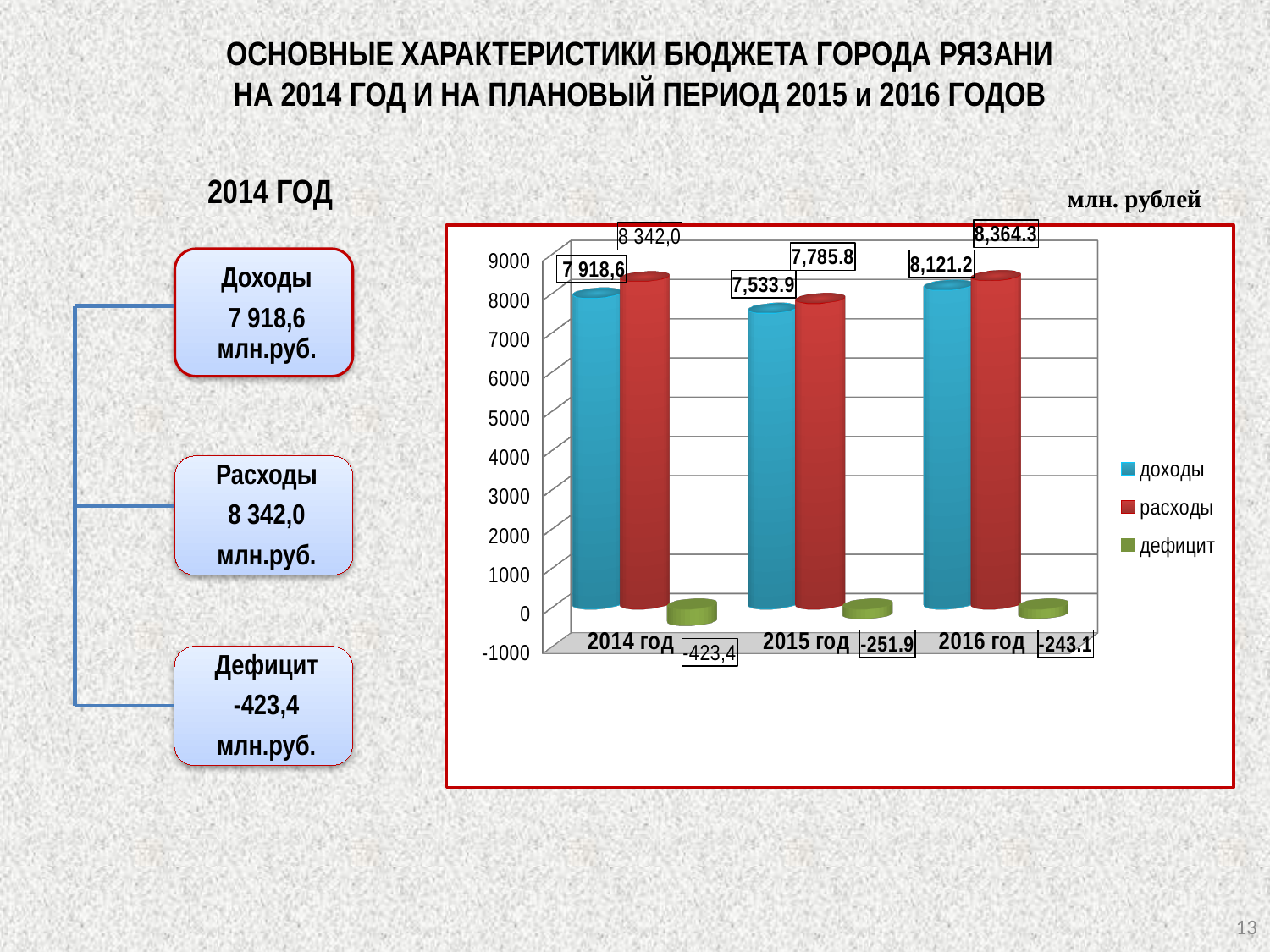
In which year is расходы the lowest? 2015 год How many years are shown on the x axis of the chart? 3 What is the value of доходы for 2014 год? 7 918,6 How many series does the chart legend list? 3 What kind of chart is shown on the slide? bar chart What is the difference between расходы and доходы for 2016 год? 243.1 Which is larger for 2015 год, доходы or расходы? расходы What is the value of расходы for 2015 год? 7,785.8 Is the value of доходы for 2015 год greater or less than 8000? less In which year is доходы the highest? 2016 год What is the value of дефицит for 2016 год? -243.1 What is the value of расходы for 2016 год? 8,364.3